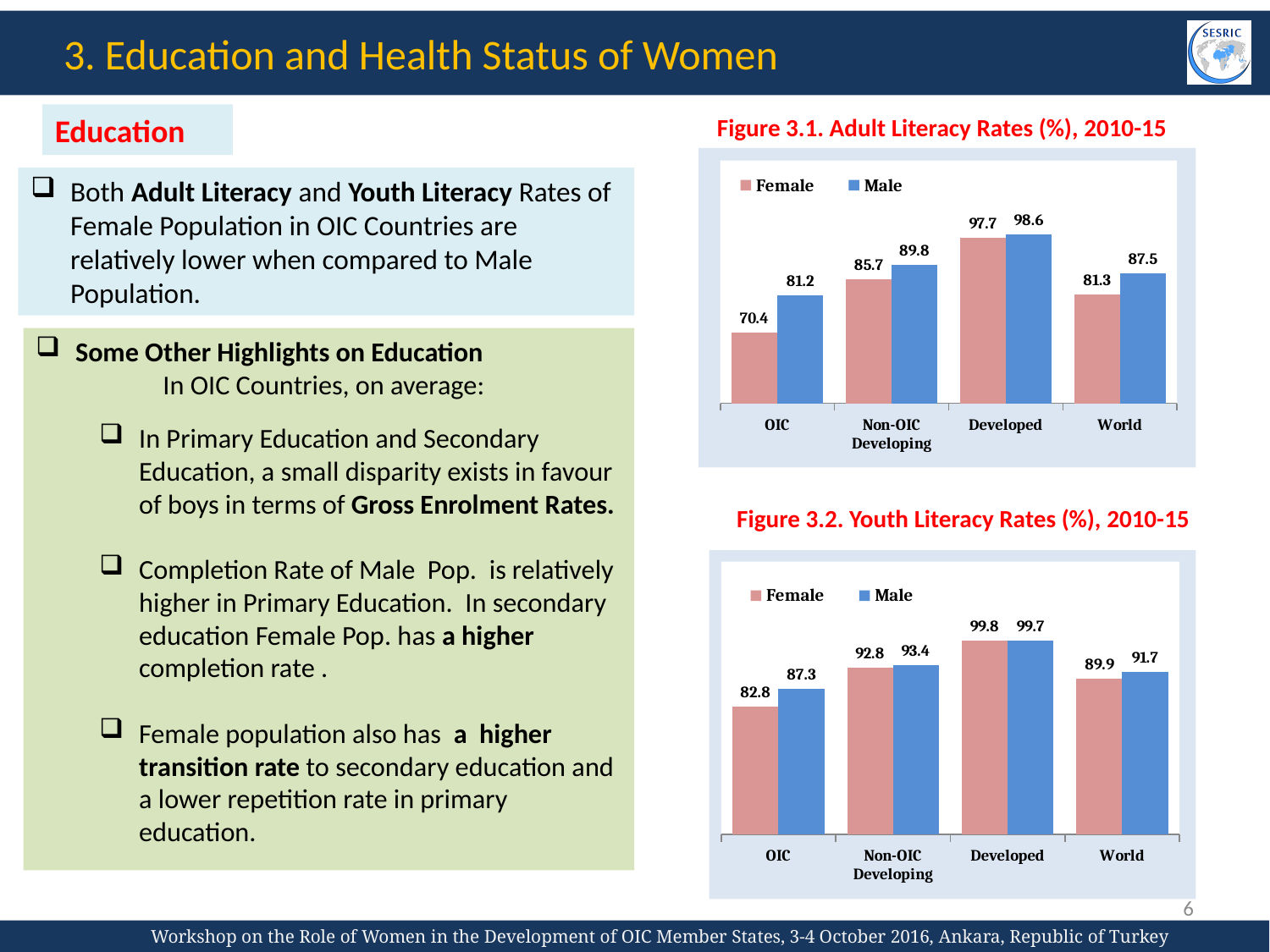
In Figure 3.1 (Adult Literacy Rates), how many series does the legend list? 2 In Figure 3.2 (Youth Literacy Rates), how many categories are shown on the x axis? 4 In Figure 3.1 (Adult Literacy Rates), what is the Female value for OIC? 70.4 In Figure 3.1 (Adult Literacy Rates), what is the difference between the Male and Female values for OIC? 10.8 In Figure 3.1 (Adult Literacy Rates), which category has the lowest Male value? OIC In Figure 3.2 (Youth Literacy Rates), what is the Female value for World? 89.9 In Figure 3.1 (Adult Literacy Rates), what is the Male value for Non-OIC Developing? 89.8 What kind of chart is Figure 3.2 (Youth Literacy Rates)? Bar chart In Figure 3.2 (Youth Literacy Rates), what is the Male value for Developed? 99.7 In Figure 3.2 (Youth Literacy Rates), what is the difference between the Male and Female values for Non-OIC Developing? 0.6 In Figure 3.2 (Youth Literacy Rates), which is larger for OIC, the Female value or the Male value? Male In Figure 3.1 (Adult Literacy Rates), which category has the highest Female value? Developed